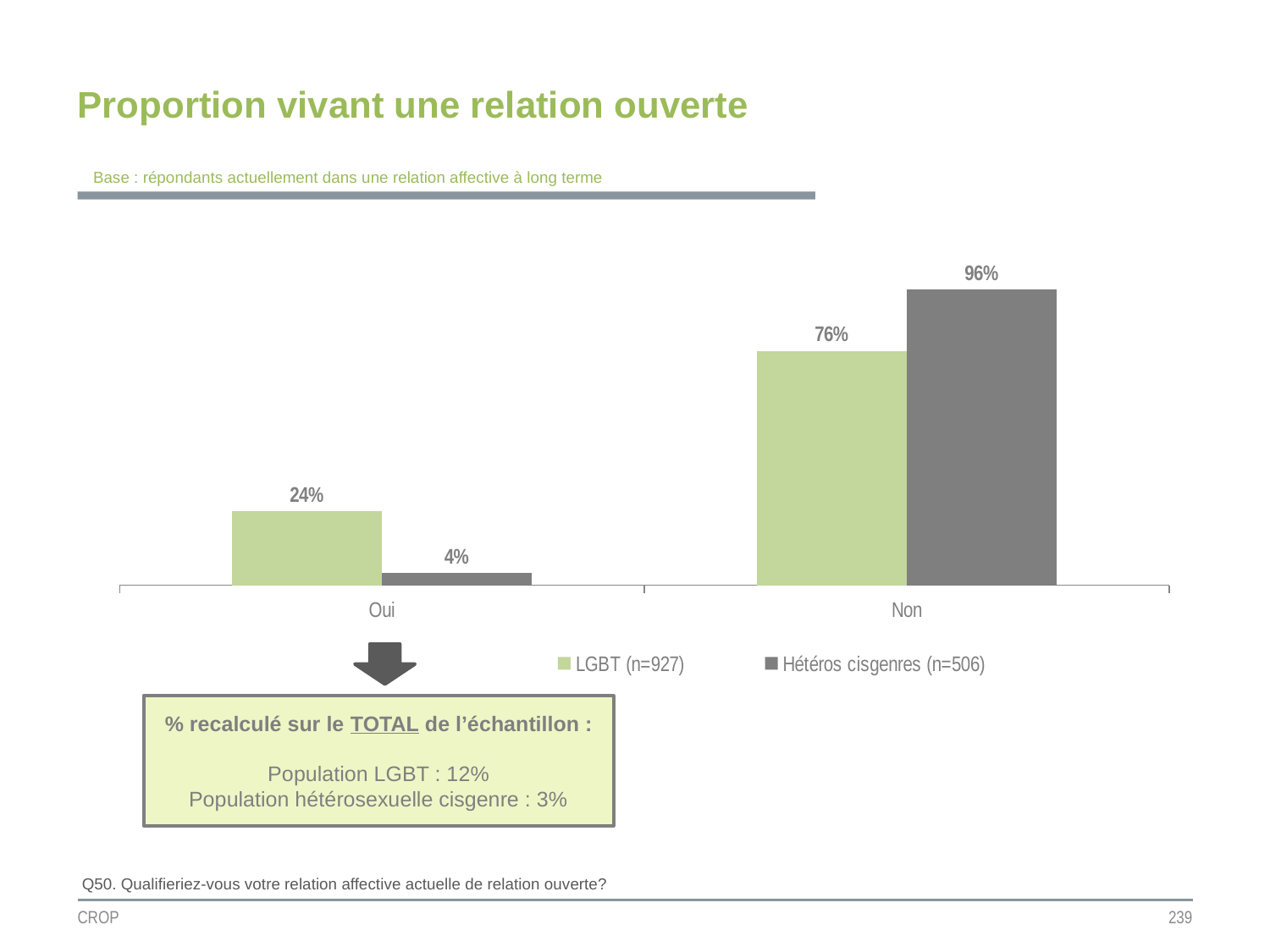
Which series has the higher value in the Oui category? LGBT (n=927) What is the difference between the Hétéros cisgenres (n=506) and LGBT (n=927) values in the Non category? 20% What is the value for LGBT (n=927) in the Oui category? 24% What is the value for LGBT (n=927) in the Non category? 76% What is the value for Hétéros cisgenres (n=506) in the Oui category? 4% Which bar is the lowest on the chart? Hétéros cisgenres (n=506), Oui What kind of chart is shown on the slide? Bar chart How many categories are shown on the x axis? 2 Which bar is the highest on the chart? Hétéros cisgenres (n=506), Non How many series does the legend list? 2 What is the difference between the LGBT (n=927) and Hétéros cisgenres (n=506) values in the Oui category? 20% What is the value for Hétéros cisgenres (n=506) in the Non category? 96%